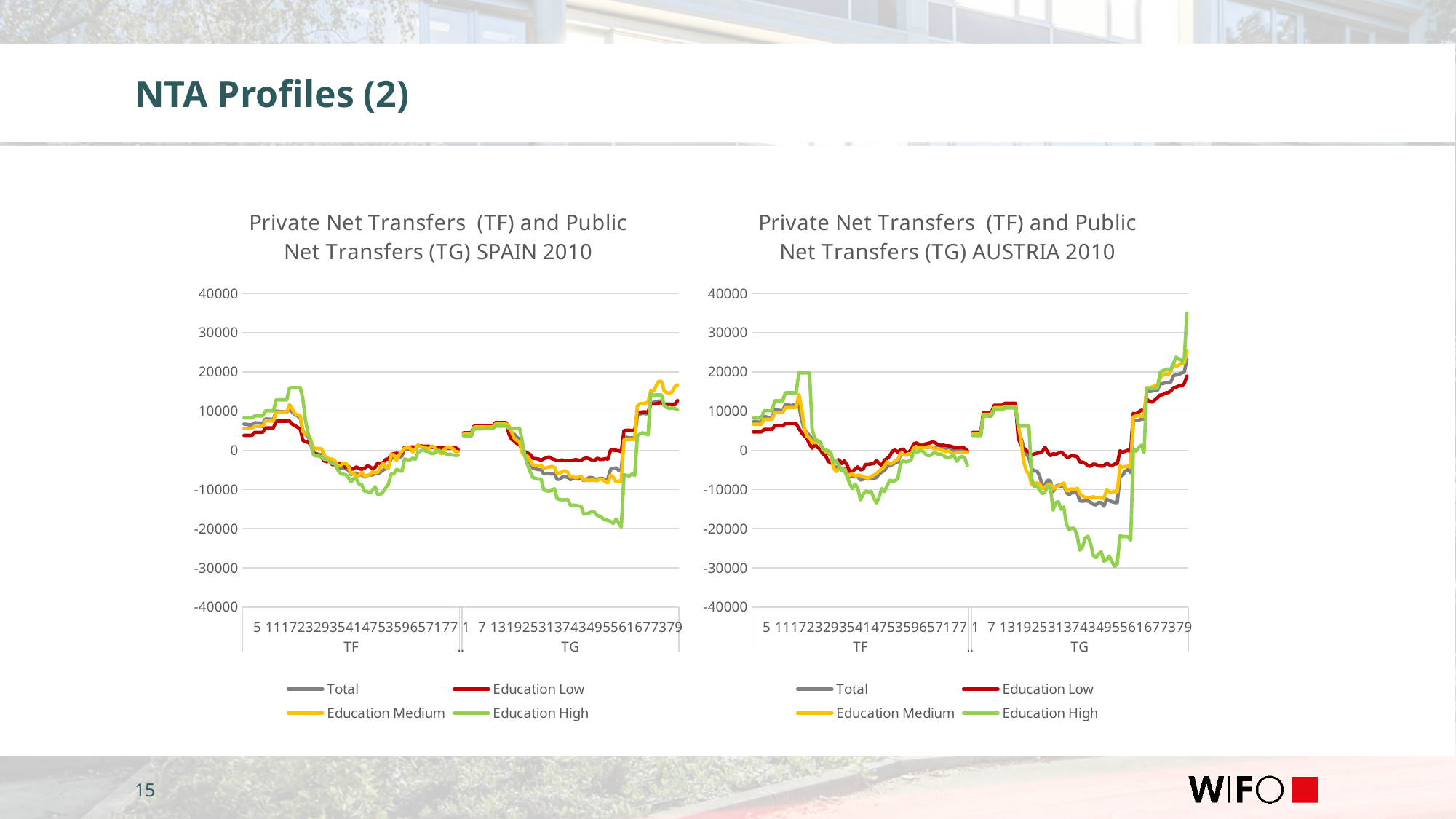
In the AUSTRIA 2010 chart, which series reaches the lowest value in the TG section? Education High In the SPAIN 2010 chart, what colour is the Education High line? green In the AUSTRIA 2010 chart, is the lowest value of the Education High line in the TG section greater or less than -20000? less In the AUSTRIA 2010 chart, is the highest value of the Education High line at the end of the TG section greater or less than 30000? greater Which series are listed in the legend of the SPAIN 2010 chart? Total, Education Low, Education Medium, Education High How many series does the legend of the AUSTRIA 2010 chart list? 4 What kind of chart is the SPAIN 2010 chart on the left? line chart In the SPAIN 2010 chart, is the lowest value of the Education High line in the TG section greater or less than -10000? less In the SPAIN 2010 chart, around age 55 in the TG section, which is higher: Education Low or Education High? Education Low What is the maximum value shown on the vertical axis of the SPAIN 2010 chart? 40000 In the AUSTRIA 2010 chart, around age 55 in the TG section, which is higher: Education Low or Education High? Education Low